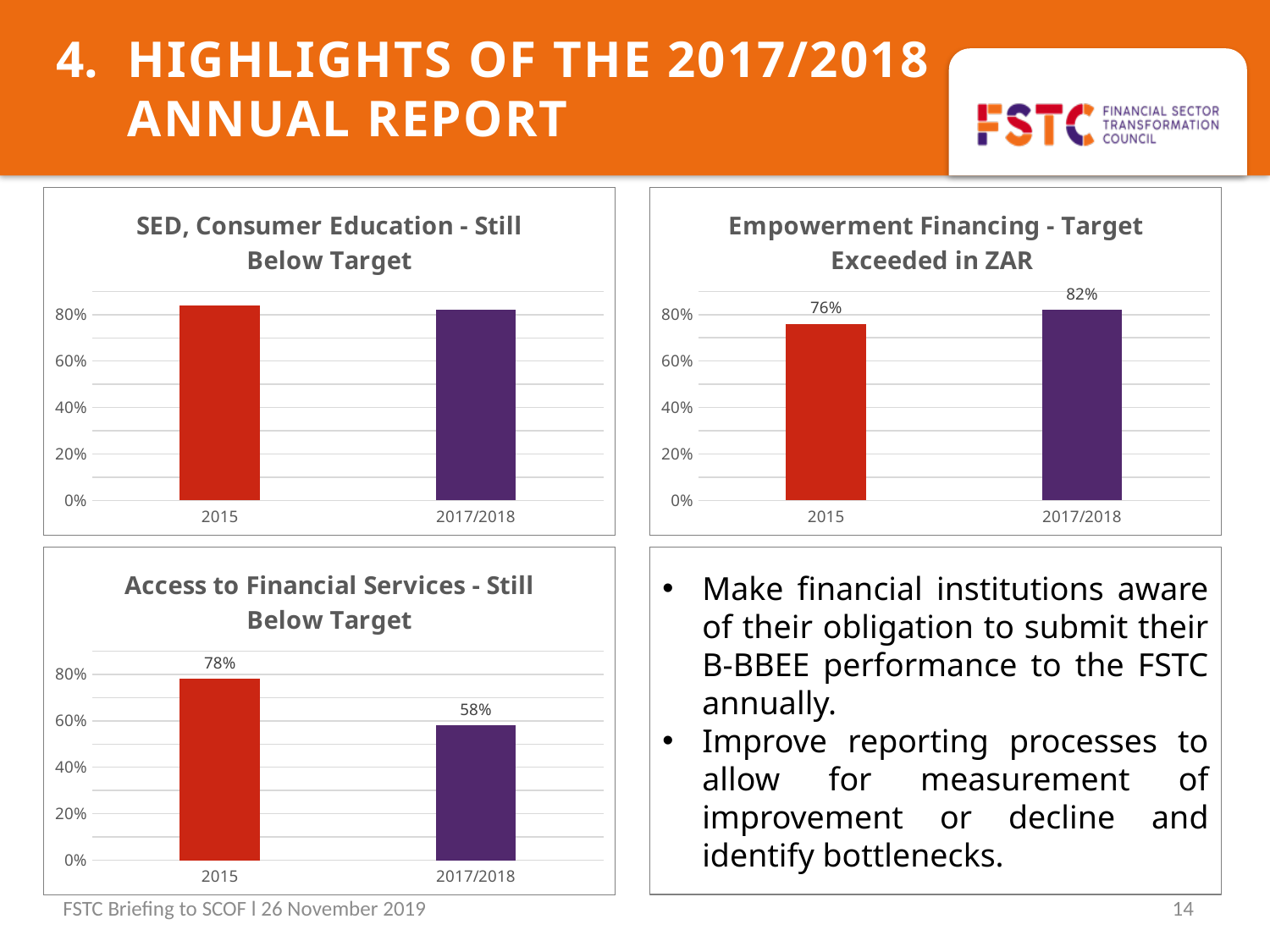
In the 'Empowerment Financing - Target Exceeded in ZAR' chart, what is the value for 2015? 76% In the 'Access to Financial Services - Still Below Target' chart, what is the difference between the 2015 and 2017/2018 values? 20% What kind of chart is the 'Empowerment Financing - Target Exceeded in ZAR' chart? bar chart In the 'SED, Consumer Education - Still Below Target' chart, is the value for 2015 greater or less than 80%? greater In the 'Empowerment Financing - Target Exceeded in ZAR' chart, by how much does the 2017/2018 value exceed the 2015 value? 6% In the 'Access to Financial Services - Still Below Target' chart, what is the value for 2017/2018? 58% In the 'Access to Financial Services - Still Below Target' chart, do the values rise or fall from 2015 to 2017/2018? fall In the 'Empowerment Financing - Target Exceeded in ZAR' chart, what is the value for 2017/2018? 82% In the 'Access to Financial Services - Still Below Target' chart, which year has the lower value? 2017/2018 In the 'Access to Financial Services - Still Below Target' chart, what is the value for 2015? 78% In the 'Empowerment Financing - Target Exceeded in ZAR' chart, which year has the higher value? 2017/2018 How many categories are shown on the x axis of the 'SED, Consumer Education - Still Below Target' chart? 2